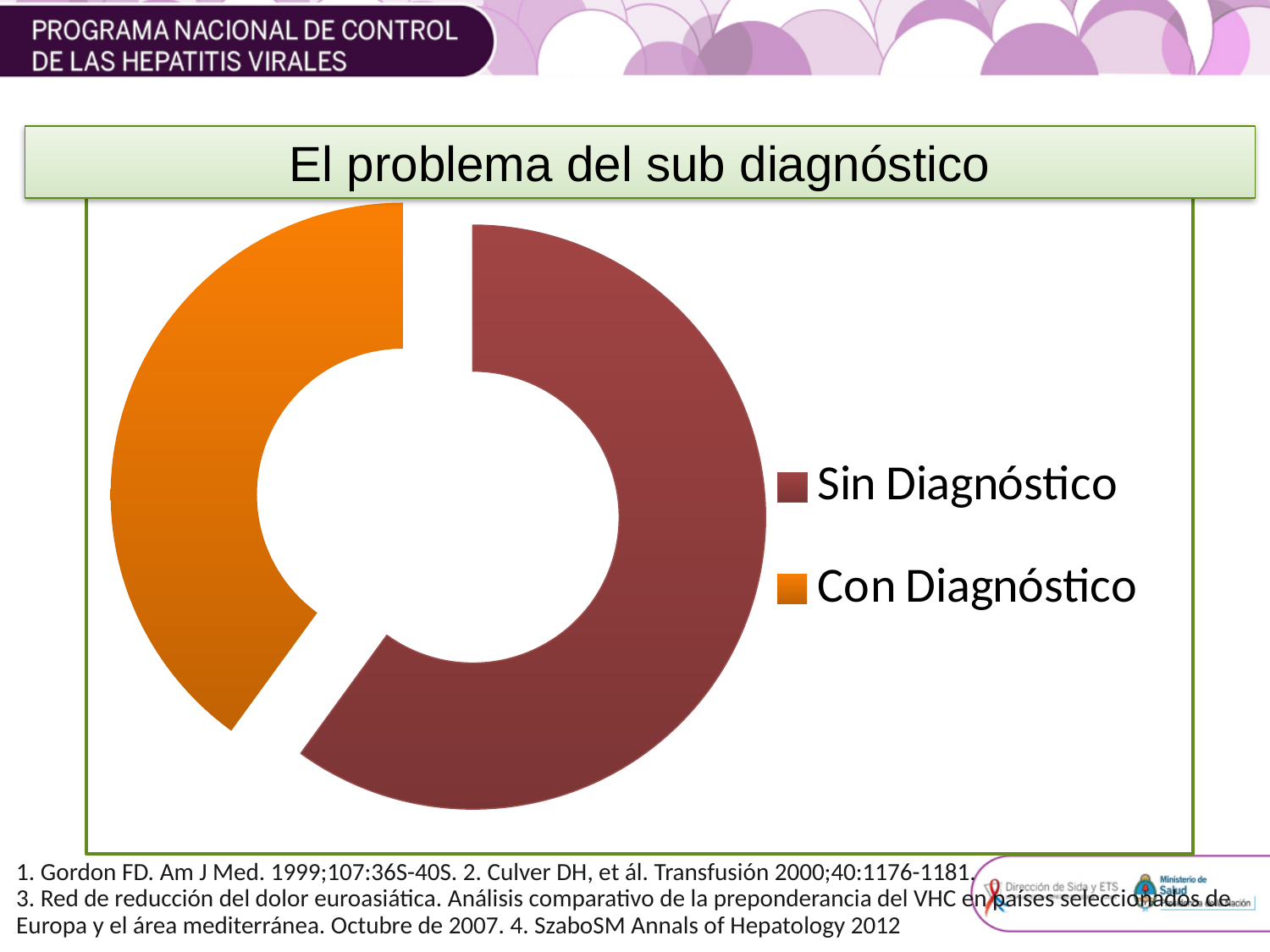
What kind of chart is shown on the slide? doughnut chart Does Sin Diagnóstico account for more or less than half of the chart? more How many categories does the chart show? 2 What colour represents Con Diagnóstico in the chart? orange Which category takes up the smallest share of the chart? Con Diagnóstico How many entries does the chart's legend list? 2 Which category takes up the largest share of the chart? Sin Diagnóstico Does Con Diagnóstico account for more or less than half of the chart? less Which is larger, the share for Sin Diagnóstico or the share for Con Diagnóstico? Sin Diagnóstico What is the title shown above the chart on the slide? El problema del sub diagnóstico